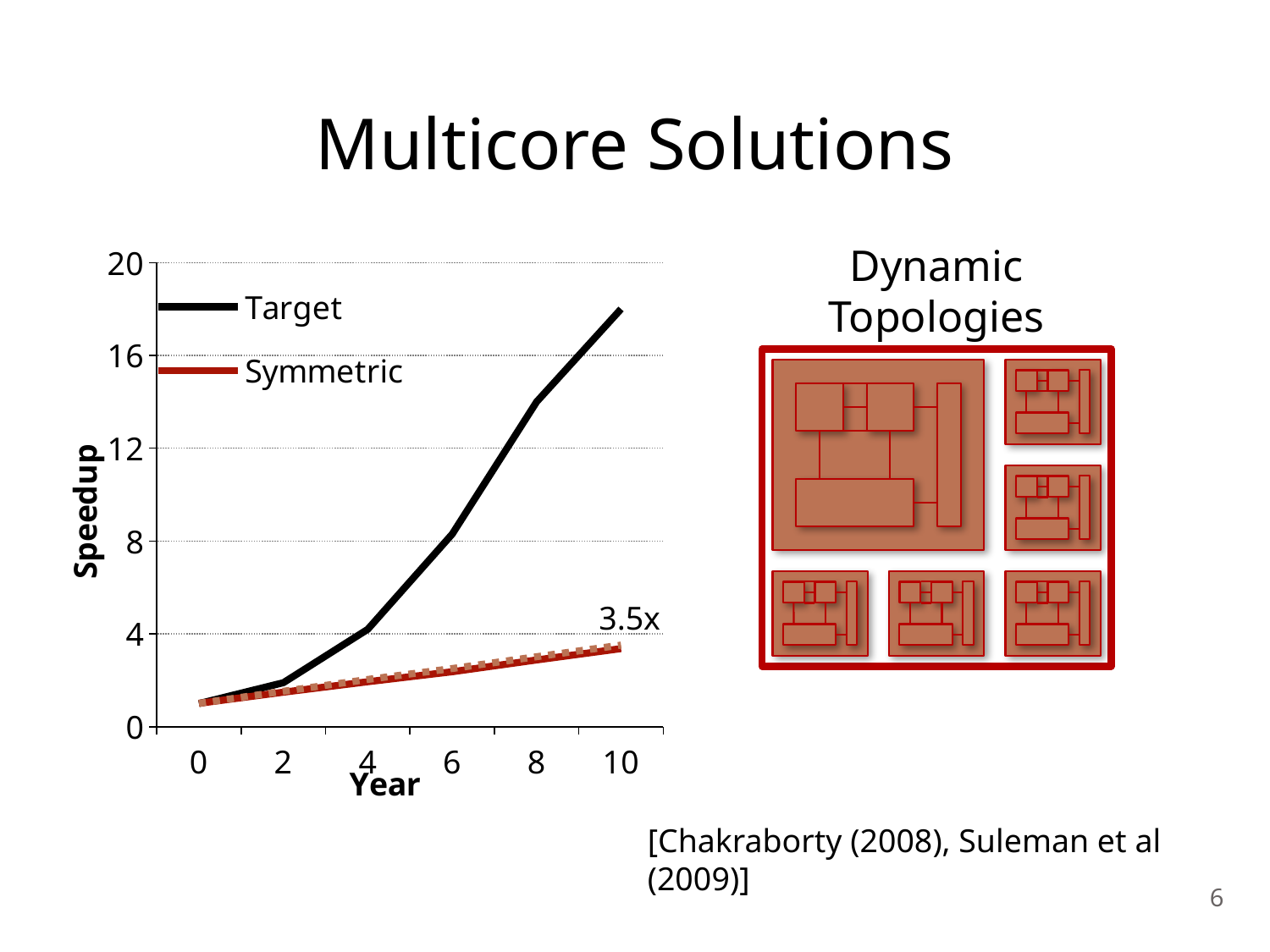
Is the Target speedup at year 6 greater or less than 12? less Is the Symmetric speedup at year 10 greater or less than 4? less Is the Target speedup at year 10 greater or less than 16? greater What speedup value is annotated for the Symmetric line at year 10? 3.5x What kind of chart is shown on the slide? line chart What is the label of the chart's y axis? Speedup How many series does the chart legend list? 2 What is the highest value shown on the Speedup axis? 20 At year 10, which series has the higher speedup, Target or Symmetric? Target What are the two series named in the chart legend? Target and Symmetric Does the Target speedup rise or fall as the year increases? rises